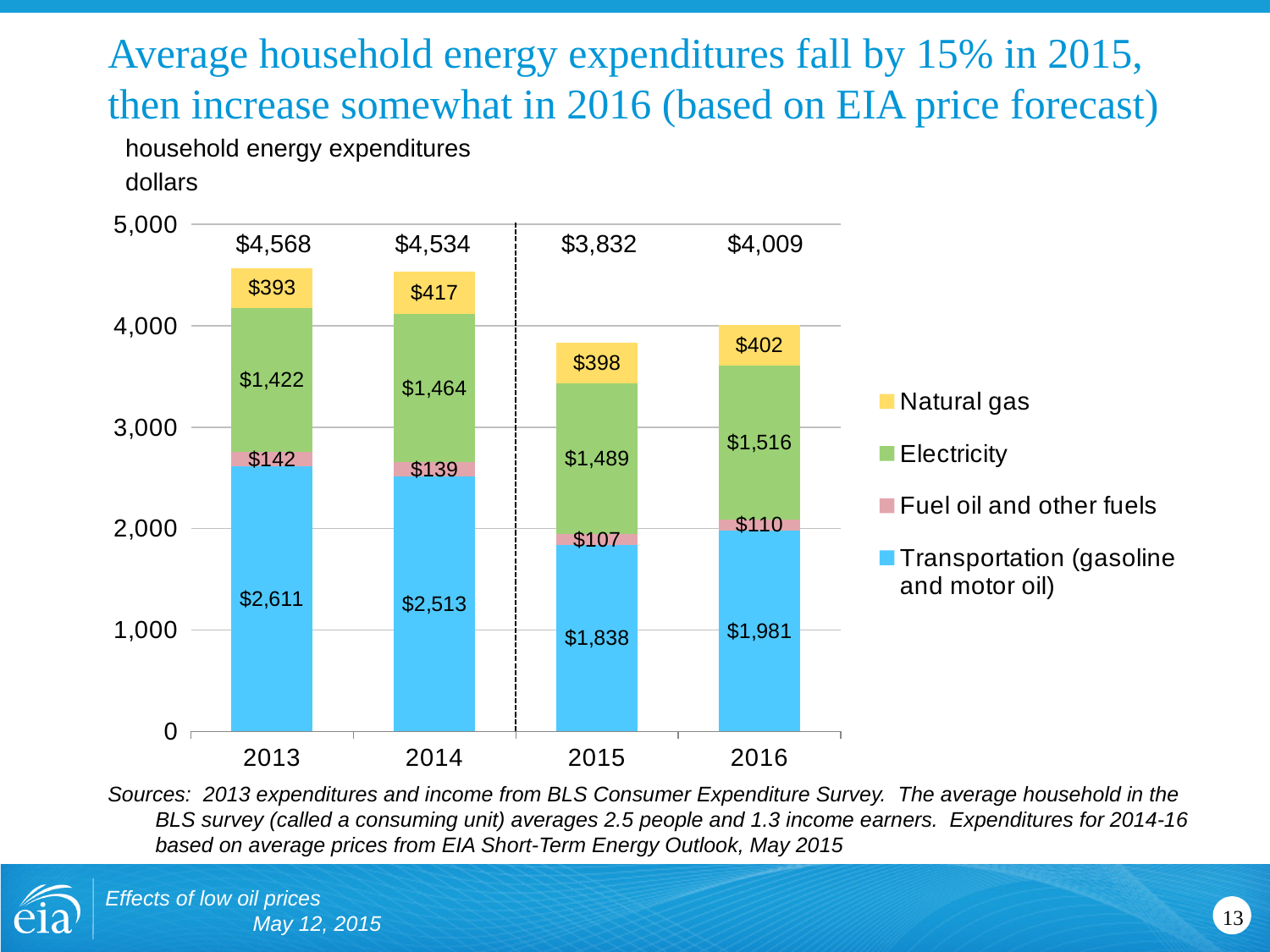
What is the Transportation (gasoline and motor oil) expenditure for 2013? $2,611 What is the total household energy expenditure for 2015? $3,832 What is the difference between the total expenditures for 2014 and 2015? $702 How many series does the legend list? 4 What kind of chart is shown on the slide? Stacked bar chart How many years are shown on the x axis? 4 What is the Natural gas expenditure for 2015? $398 Is the Electricity expenditure larger in 2015 or in 2016? 2016 Which year has the highest total household energy expenditure? 2013 What is the Fuel oil and other fuels expenditure for 2014? $139 Which year has the lowest Transportation (gasoline and motor oil) expenditure? 2015 What is the Electricity expenditure for 2016? $1,516